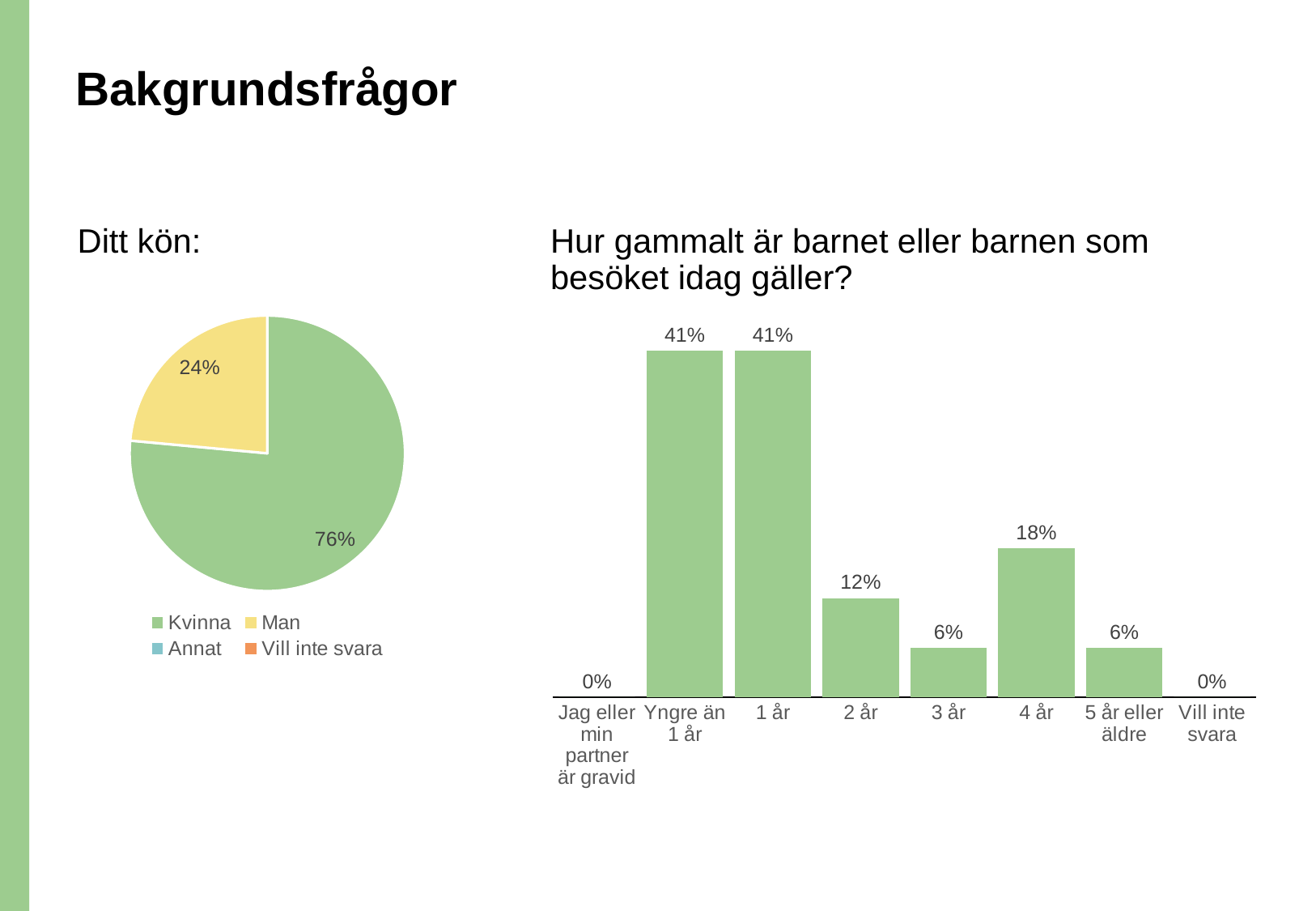
In the pie chart 'Ditt kön:', what share is Man? 24% In the bar chart 'Hur gammalt är barnet eller barnen som besöket idag gäller?', what is the value for 4 år? 18% What kind of chart is the chart titled 'Hur gammalt är barnet eller barnen som besöket idag gäller?'? Bar chart What kind of chart is the chart on the left of the slide? Pie chart In the bar chart 'Hur gammalt är barnet eller barnen som besöket idag gäller?', what is the value for Vill inte svara? 0% In the bar chart 'Hur gammalt är barnet eller barnen som besöket idag gäller?', how many categories are shown on the x axis? 8 In the bar chart 'Hur gammalt är barnet eller barnen som besöket idag gäller?', what is the value for 5 år eller äldre? 6% In the bar chart 'Hur gammalt är barnet eller barnen som besöket idag gäller?', what is the value for 2 år? 12% In the bar chart 'Hur gammalt är barnet eller barnen som besöket idag gäller?', what is the difference between the values for 1 år and 3 år? 35% In the pie chart 'Ditt kön:', what share is Kvinna? 76% In the pie chart 'Ditt kön:', how many entries does the legend list? 4 In the bar chart 'Hur gammalt är barnet eller barnen som besöket idag gäller?', which is larger, the value for 2 år or the value for 4 år? 4 år